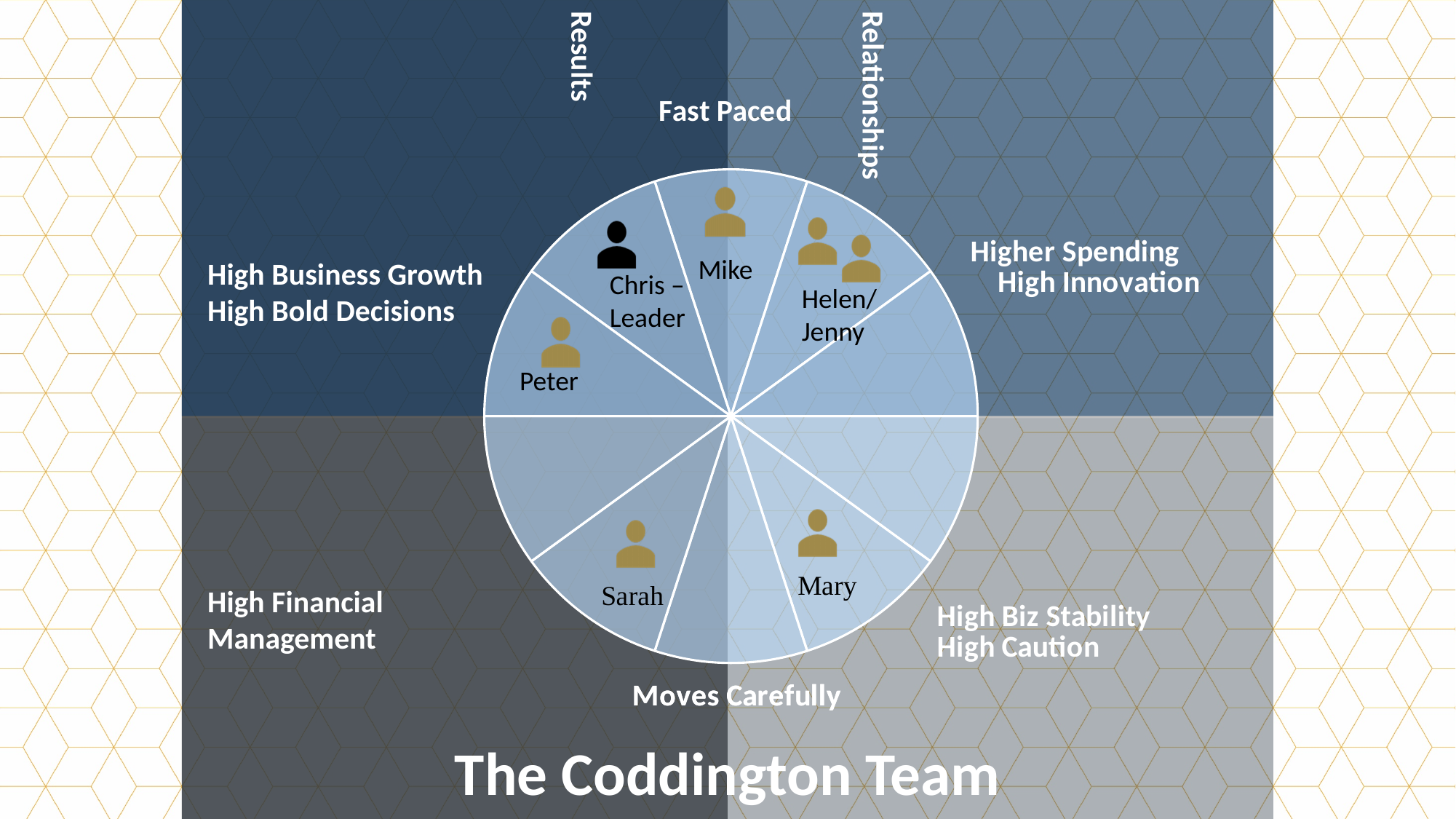
Which team member's icon is black rather than gold? Chris Which quadrant is Sarah placed in? High Financial Management What is the title of the slide? The Coddington Team Which quadrant is Peter placed in? High Business Growth / High Bold Decisions Which quadrant is Mary placed in? High Biz Stability / High Caution How many segments is the circular chart divided into? 10 How many named team members are placed on the chart? 7 Which quadrant are Helen and Jenny placed in? Higher Spending / High Innovation What label appears at the top of the circular chart? Fast Paced Which segment of the chart contains two people? Helen/Jenny What kind of chart is shown on the slide? pie chart Which team member is labelled as the Leader? Chris